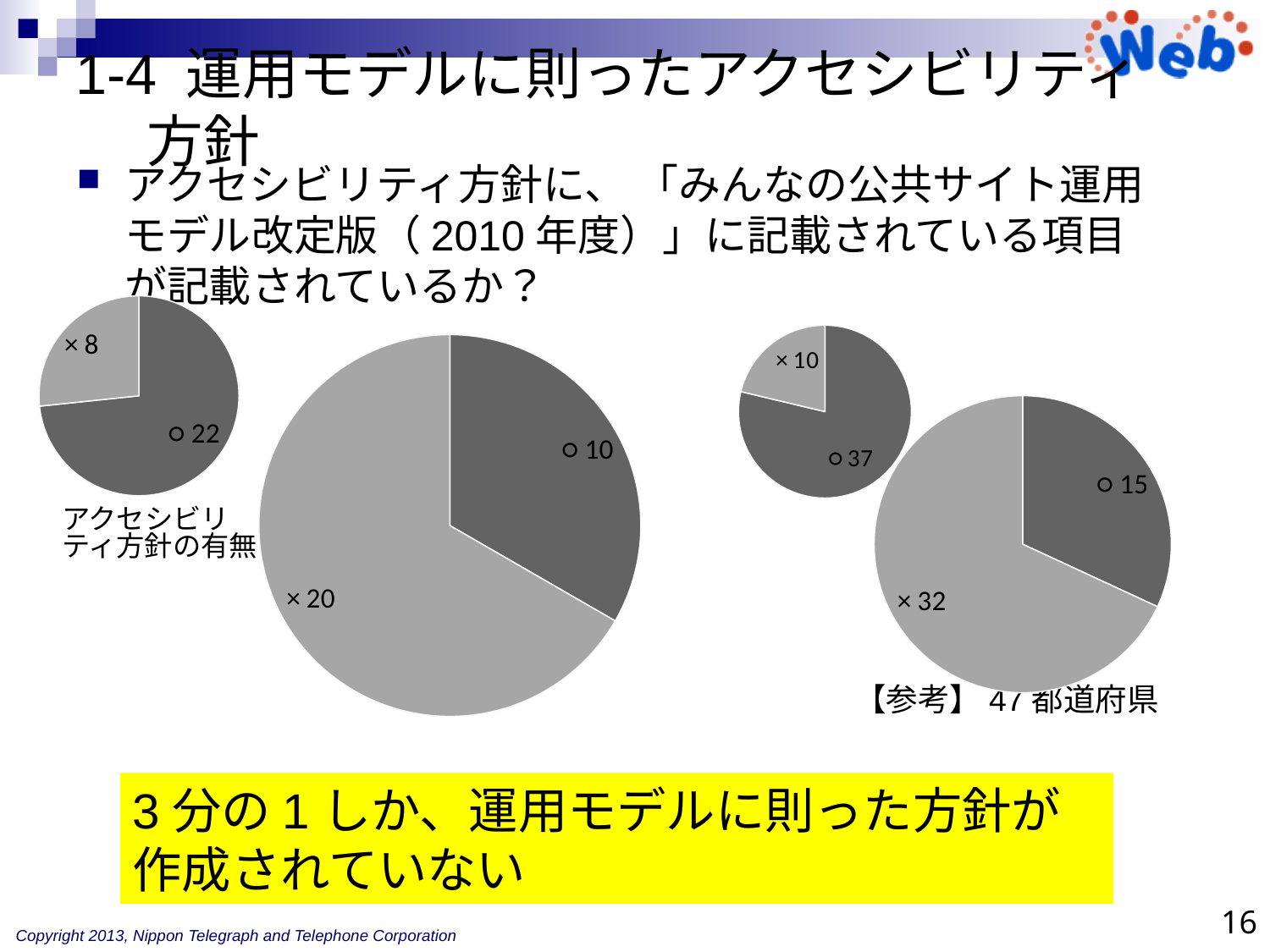
In the small pie chart at the top left labelled アクセシビリティ方針の有無, what is the value for ×? 8 What type of chart is used to show the data on this slide? Pie chart How many pie charts are shown on the slide? 4 In the large pie chart in the centre of the slide, which slice is larger, ○ or ×? × In the small pie chart at the top right (the 47 都道府県 reference), what is the value for ○? 37 In the large pie chart at the right (the 47 都道府県 reference), what is the value for ×? 32 In the large pie chart in the centre of the slide, what is the value for ×? 20 In the small pie chart at the top left labelled アクセシビリティ方針の有無, what is the value for ○? 22 In the large pie chart in the centre of the slide, what is the value for ○? 10 In the small pie chart at the top left labelled アクセシビリティ方針の有無, what is the difference between the ○ value and the × value? 14 In the large pie chart in the centre of the slide, what fraction of the total does the ○ slice represent? 1/3 In the large pie chart at the right (the 47 都道府県 reference), what is the difference between the × value and the ○ value? 17